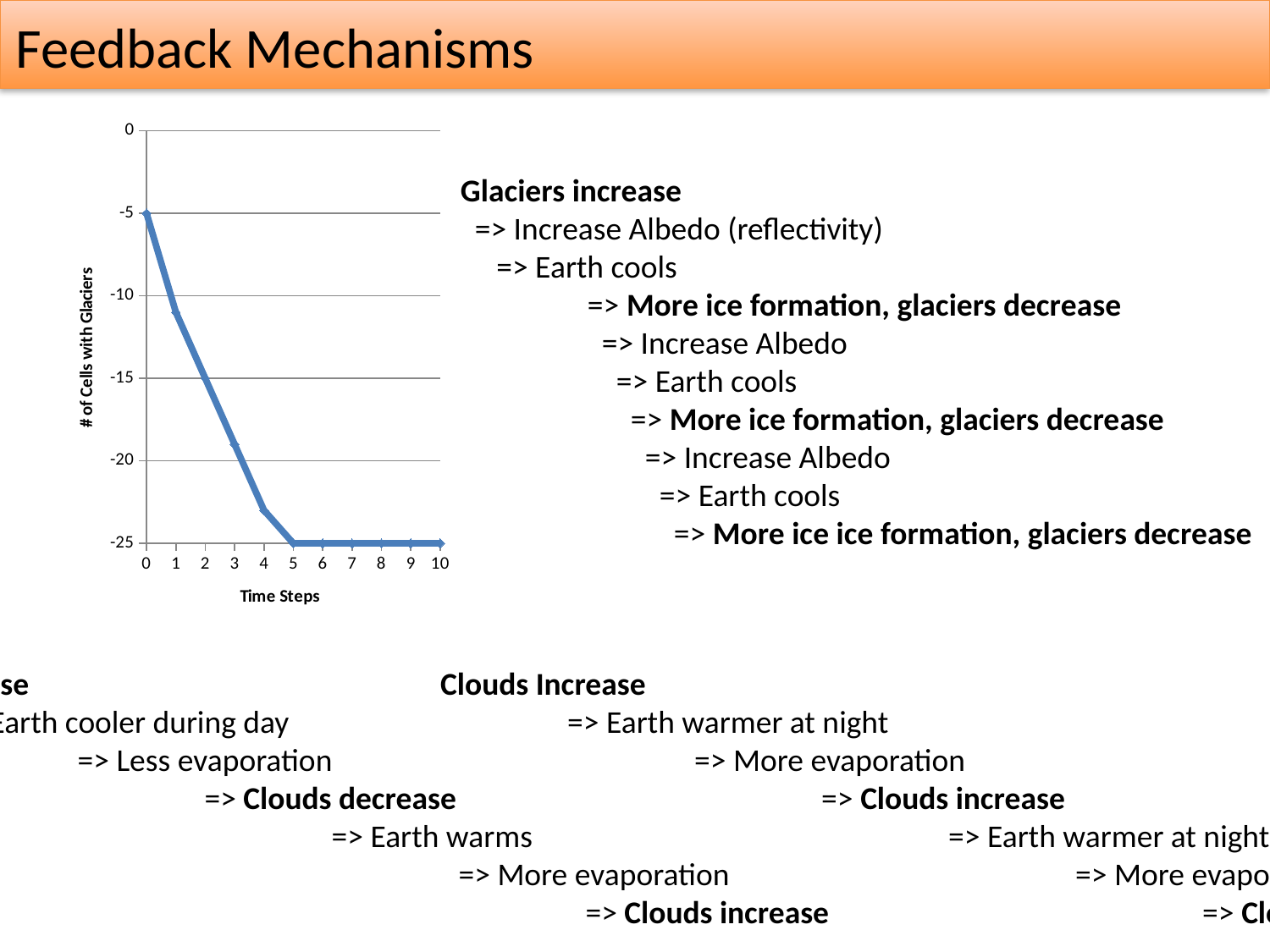
What kind of chart is shown on the slide? line chart What is the value of # of Cells with Glaciers at time step 10? -25 Do the values rise or fall as the time steps increase from 0 to 5? fall What is the value of # of Cells with Glaciers at time step 5? -25 Is the value at time step 3 greater or less than -15? less What is the label of the x axis of the chart? Time Steps Which has the larger value, time step 1 or time step 3? time step 1 At which time step is the value of # of Cells with Glaciers highest? 0 What is the label of the y axis of the chart? # of Cells with Glaciers At which time step does the line first reach -25? 5 What is the value of # of Cells with Glaciers at time step 0? -5 What is the difference between the value at time step 0 and the value at time step 5? 20